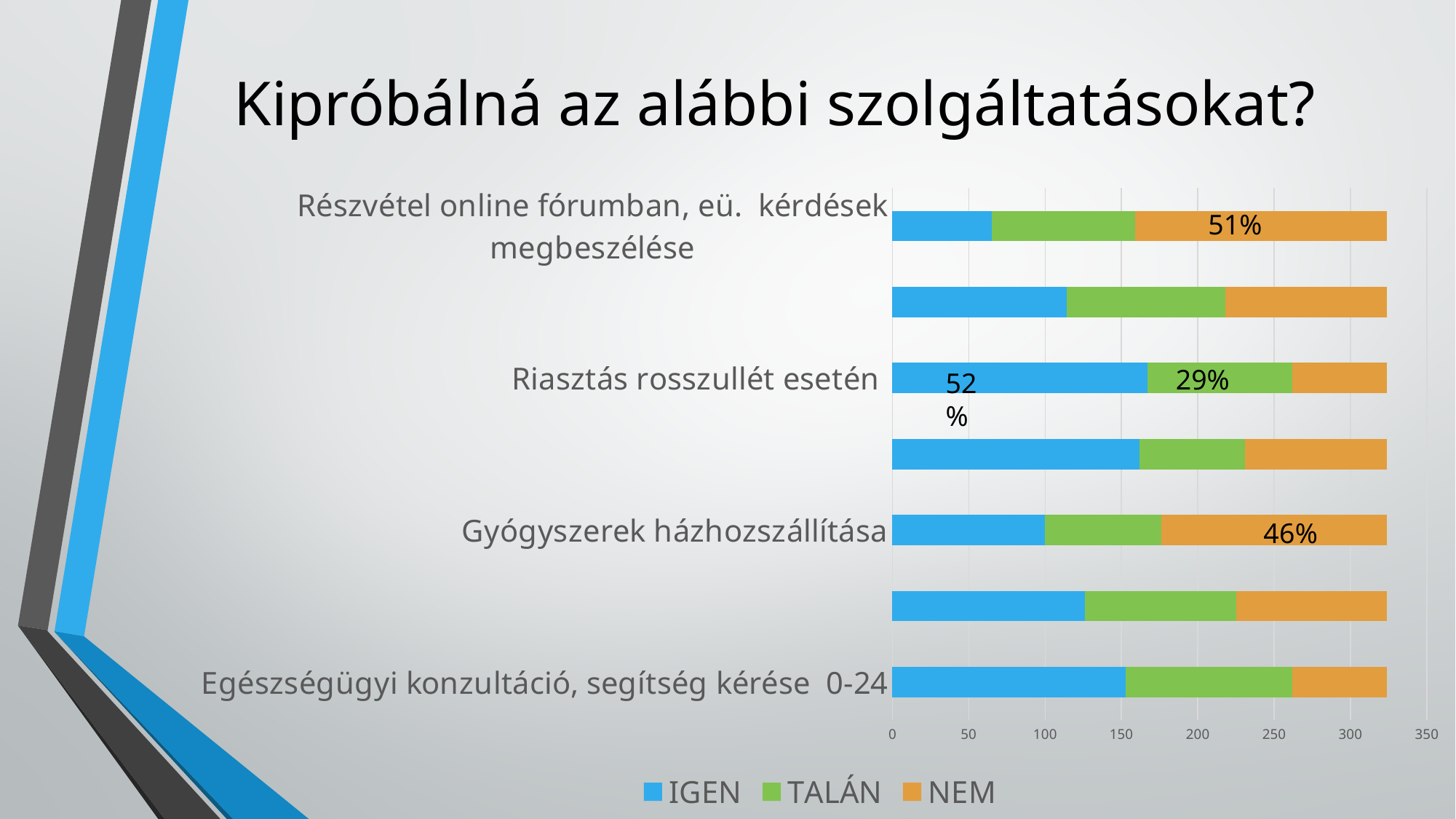
How many series does the legend list? 3 What is the NEM percentage shown for 'Gyógyszerek házhozszállítása'? 46% Is the IGEN value for 'Részvétel online fórumban, eü. kérdések megbeszélése' greater or less than 100? less What is the difference between the NEM percentage for 'Részvétel online fórumban, eü. kérdések megbeszélése' (51%) and for 'Gyógyszerek házhozszállítása' (46%)? 5 percentage points What kind of chart is shown on the slide? stacked bar chart What is the IGEN percentage shown for 'Riasztás rosszullét esetén'? 52% Is the IGEN value for 'Gyógyszerek házhozszállítása' greater or less than 150? less What are the legend entries of the chart? IGEN, TALÁN, NEM What is the TALÁN percentage shown for 'Riasztás rosszullét esetén'? 29% What is the NEM percentage shown for 'Részvétel online fórumban, eü. kérdések megbeszélése'? 51% Which has the larger IGEN segment: 'Riasztás rosszullét esetén' or 'Gyógyszerek házhozszállítása'? Riasztás rosszullét esetén Which has the larger NEM percentage label: 'Részvétel online fórumban, eü. kérdések megbeszélése' or 'Gyógyszerek házhozszállítása'? Részvétel online fórumban, eü. kérdések megbeszélése